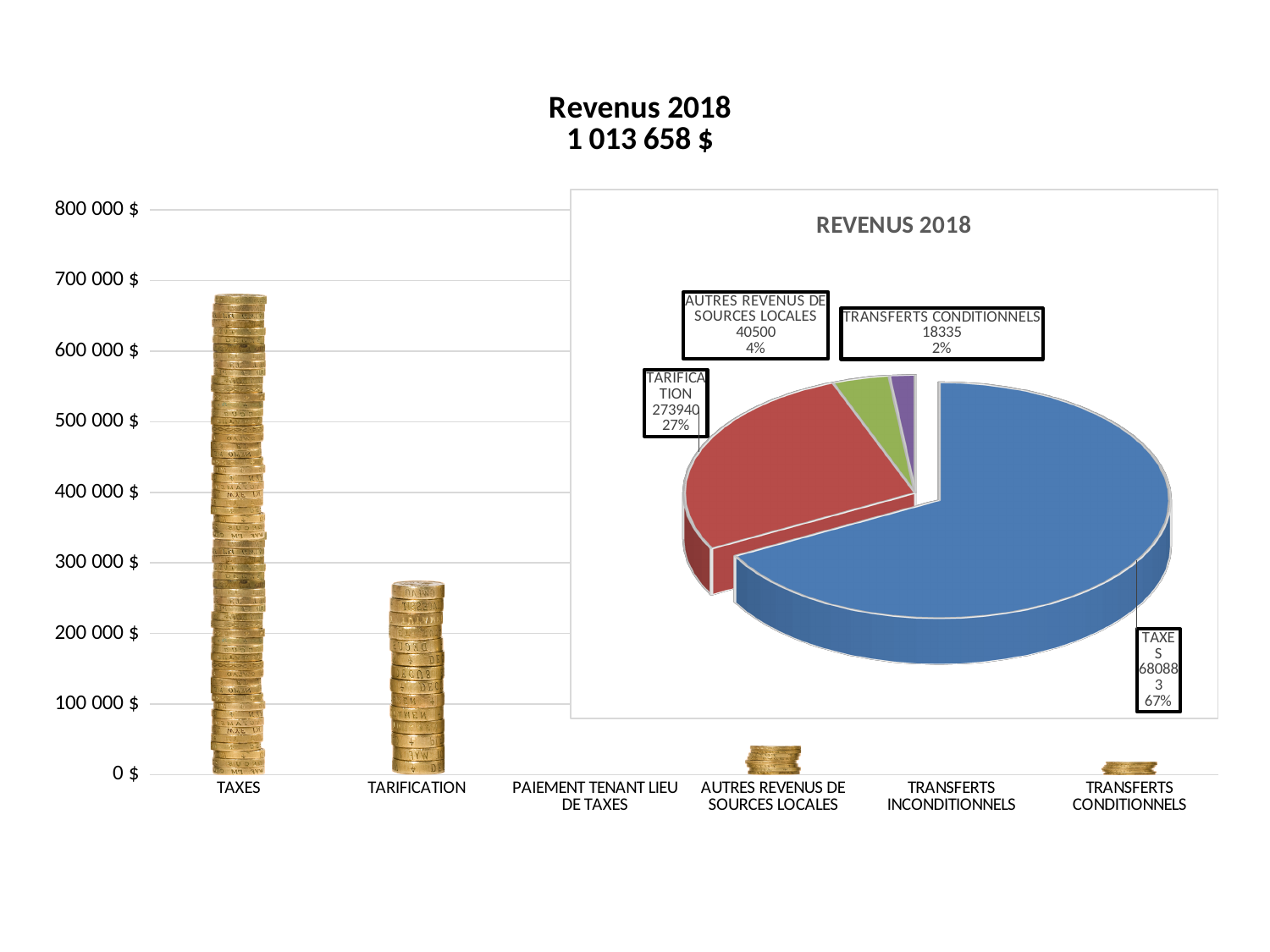
In the pie chart REVENUS 2018, what is the difference between the values for TARIFICATION and TRANSFERTS CONDITIONNELS? 255605 In the pie chart REVENUS 2018, what share of the pie is AUTRES REVENUS DE SOURCES LOCALES? 4% In the pie chart REVENUS 2018, what share of the pie is TAXES? 67% In the bar chart on the left, is the value for TARIFICATION greater or less than 300 000 $? less What kind of chart is the chart on the left side of the slide? bar chart What kind of chart is the chart titled REVENUS 2018 on the right side of the slide? pie chart In the bar chart on the left, which category has the highest value? TAXES In the pie chart REVENUS 2018, what is the value for TRANSFERTS CONDITIONNELS? 18335 How many categories are shown on the x axis of the bar chart on the left? 6 In the bar chart on the left, is the value for TAXES greater or less than 600 000 $? greater In the pie chart REVENUS 2018, what is the value for TARIFICATION? 273940 What total amount is shown in the title above the bar chart on the left? 1 013 658 $